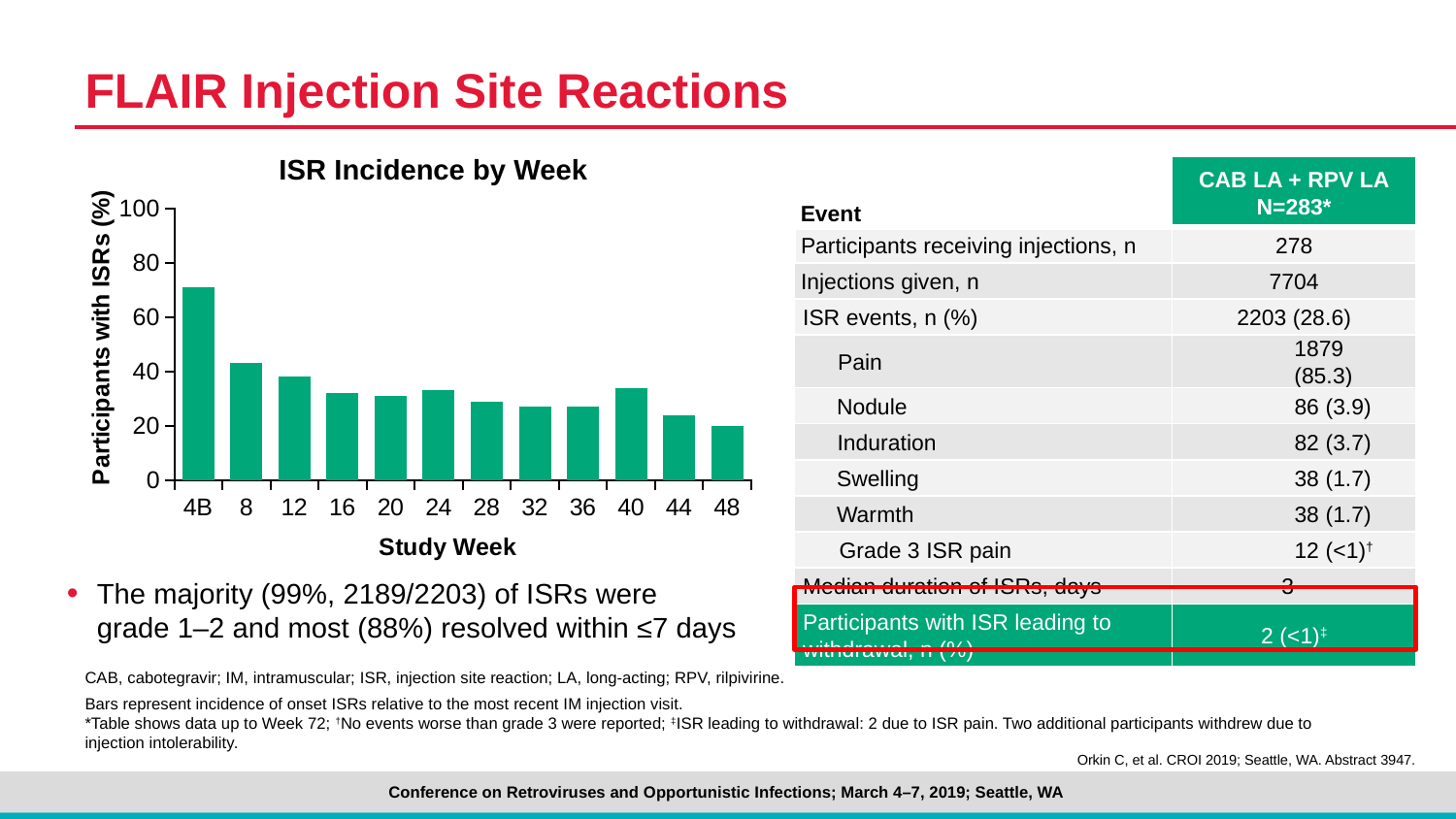
Overall, do the percentages of participants with ISRs rise or fall from Week 4B to Week 48? fall What kind of chart is the ISR Incidence by Week chart? bar chart Is the value for Week 4B greater or less than 60? greater Is the value for Week 48 greater or less than 40? less Is the value for Week 16 greater or less than 40? less Which has a higher percentage of participants with ISRs, Week 40 or Week 44? Week 40 Which study week has the highest percentage of participants with ISRs? 4B Which study week has the lowest percentage of participants with ISRs? 48 Which has a higher percentage of participants with ISRs, Week 4B or Week 8? Week 4B How many study weeks are shown on the x axis of the ISR Incidence by Week chart? 12 What is the label of the y axis on the ISR Incidence by Week chart? Participants with ISRs (%)